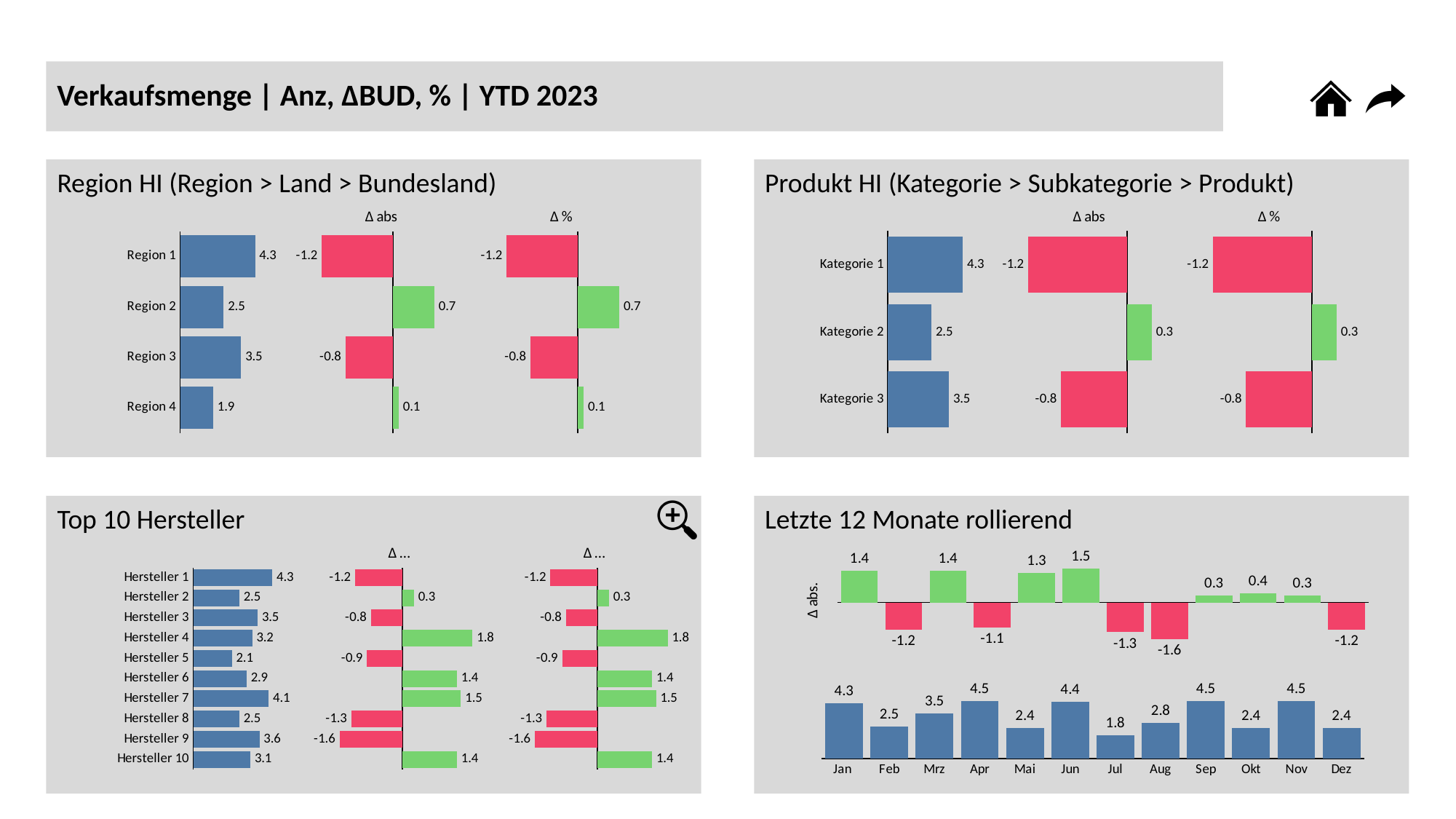
In the 'Top 10 Hersteller' chart, what is the difference between the values for Hersteller 7 and Hersteller 5? 2.0 In the 'Produkt HI' chart, how many categories are shown? 3 In the 'Region HI' chart, what is the value for Region 3? 3.5 In the 'Letzte 12 Monate rollierend' chart, is the value for Apr or Mai larger in the lower bar chart? Apr What kind of chart is used in the 'Letzte 12 Monate rollierend' panel? Bar chart In the 'Produkt HI' chart, what is the Δ abs value for Kategorie 3? -0.8 In the 'Letzte 12 Monate rollierend' chart, which month has the lowest Δ abs value? Aug In the 'Top 10 Hersteller' chart, which Hersteller has the highest value? Hersteller 1 In the 'Top 10 Hersteller' chart, what is the Δ value for Hersteller 4? 1.8 In the 'Region HI' chart, which region has the lowest value? Region 4 In the 'Region HI' chart, what is the Δ abs value for Region 2? 0.7 In the 'Letzte 12 Monate rollierend' chart, what is the value for Jul in the lower bar chart? 1.8